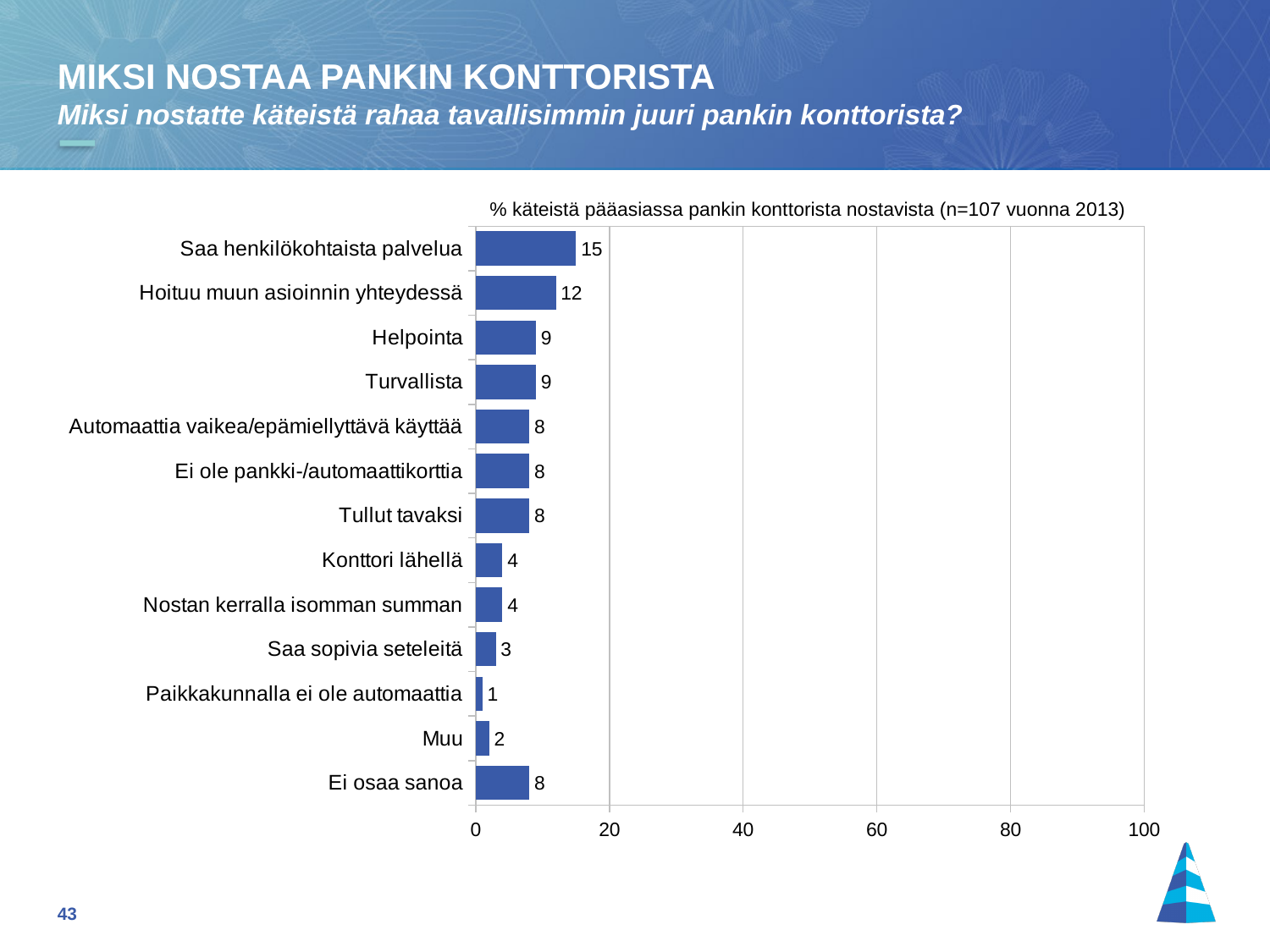
Which category has the highest value? Saa henkilökohtaista palvelua What kind of chart is shown on the slide? bar chart Which category has the lowest value? Paikkakunnalla ei ole automaattia Which is larger, the value for "Helpointa" or the value for "Saa sopivia seteleitä"? Helpointa What is the difference between the values for "Saa henkilökohtaista palvelua" and "Hoituu muun asioinnin yhteydessä"? 3 What is the value for "Konttori lähellä"? 4 What is the maximum value shown on the horizontal axis? 100 What is the value for "Saa henkilökohtaista palvelua"? 15 What is the value for "Ei osaa sanoa"? 8 What is the value for "Hoituu muun asioinnin yhteydessä"? 12 How many categories are shown in the chart? 13 Is the value for "Saa henkilökohtaista palvelua" greater or less than 20? less